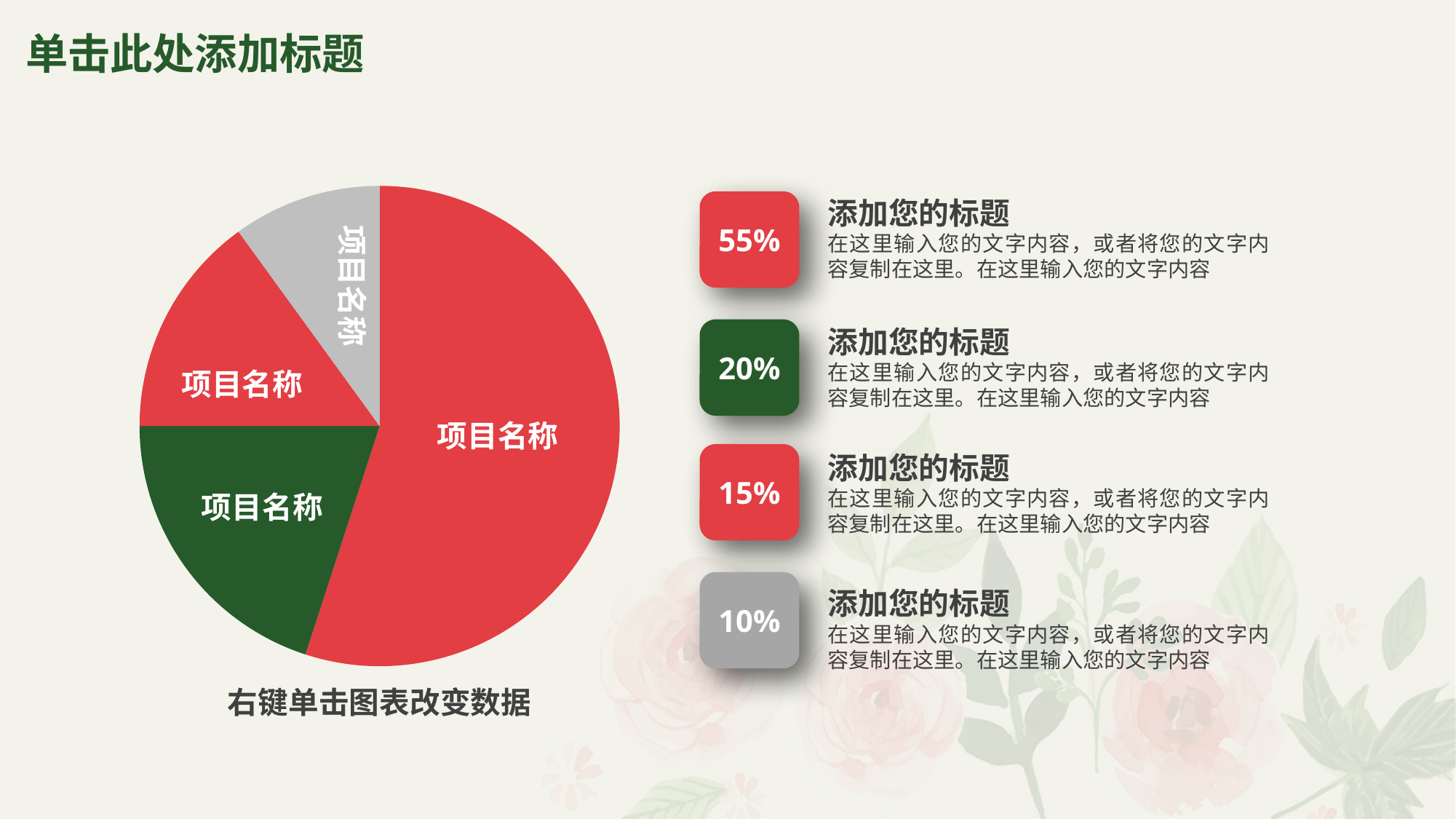
Which is larger in the pie chart, the small red slice on the upper left or the gray slice? the small red slice on the upper left How many slices does the pie chart have? 4 What caption appears below the pie chart? 右键单击图表改变数据 Which slice of the pie chart is the smallest? the gray slice Which slice of the pie chart is the largest? the large red slice on the right Which is larger in the pie chart, the large red slice on the right or the green slice? the large red slice on the right Which is larger in the pie chart, the green slice or the gray slice? the green slice What kind of chart is shown on the slide? pie chart Does the largest slice of the pie chart take up more or less than half of the pie? more What label is shown on each slice of the pie chart? 项目名称